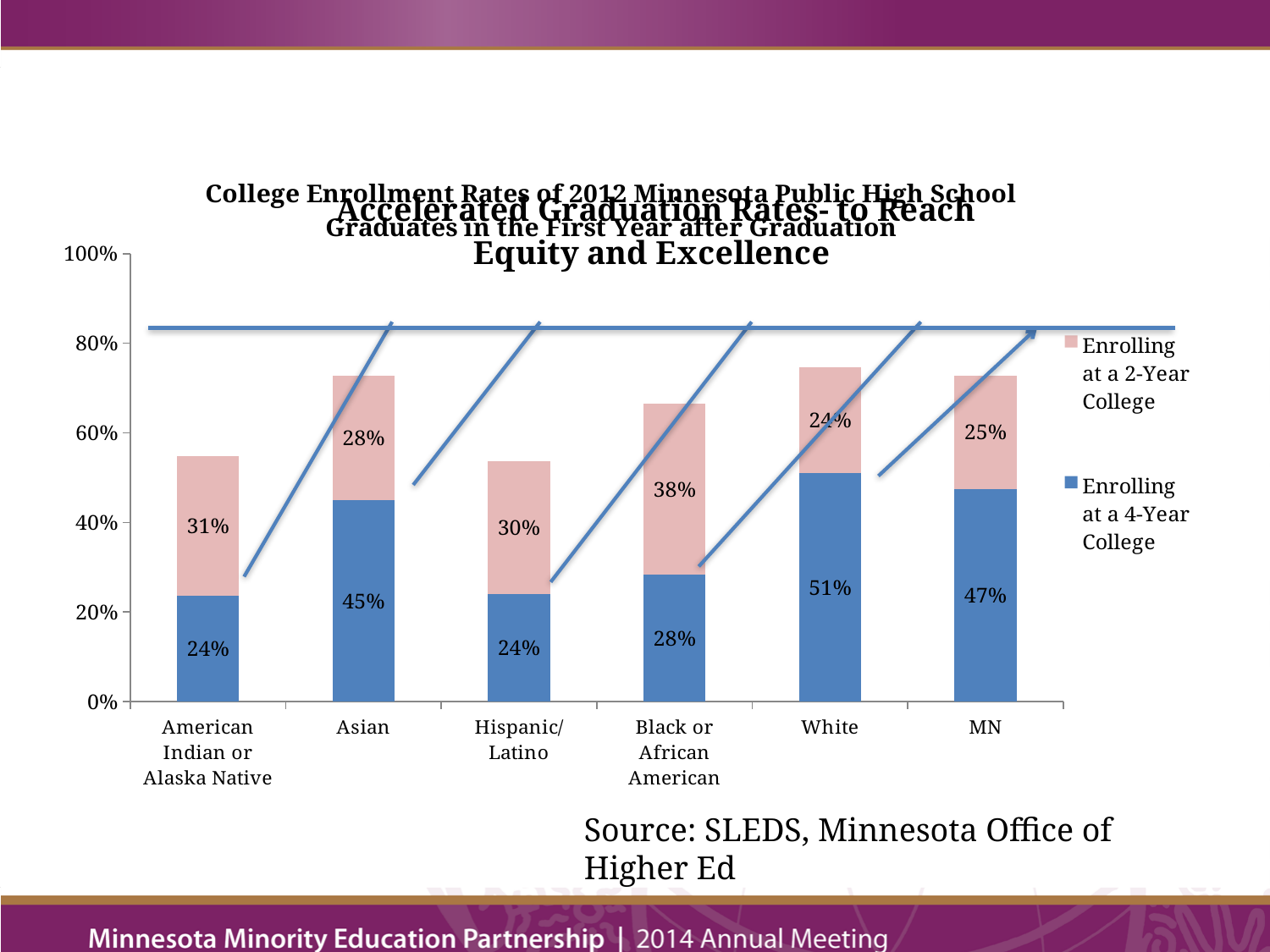
What is the total college enrollment rate (2-Year plus 4-Year) for American Indian or Alaska Native graduates? 55% What percentage of Asian graduates enrolled at a 4-Year College? 45% What type of chart is shown on the slide? Stacked bar chart How many series does the chart legend list? 2 How many groups are shown along the x axis of the chart? 6 Which group has the highest rate of Enrolling at a 4-Year College? White Which is larger: the 4-Year College enrollment rate for Asian graduates or for MN overall? MN What is the value for MN for Enrolling at a 4-Year College? 47% Which group has the lowest rate of Enrolling at a 2-Year College? White What percentage of Black or African American graduates enrolled at a 2-Year College? 38% Which group has the highest rate of Enrolling at a 2-Year College? Black or African American What is the difference between the 4-Year College enrollment rates of White and Hispanic/Latino graduates? 27%